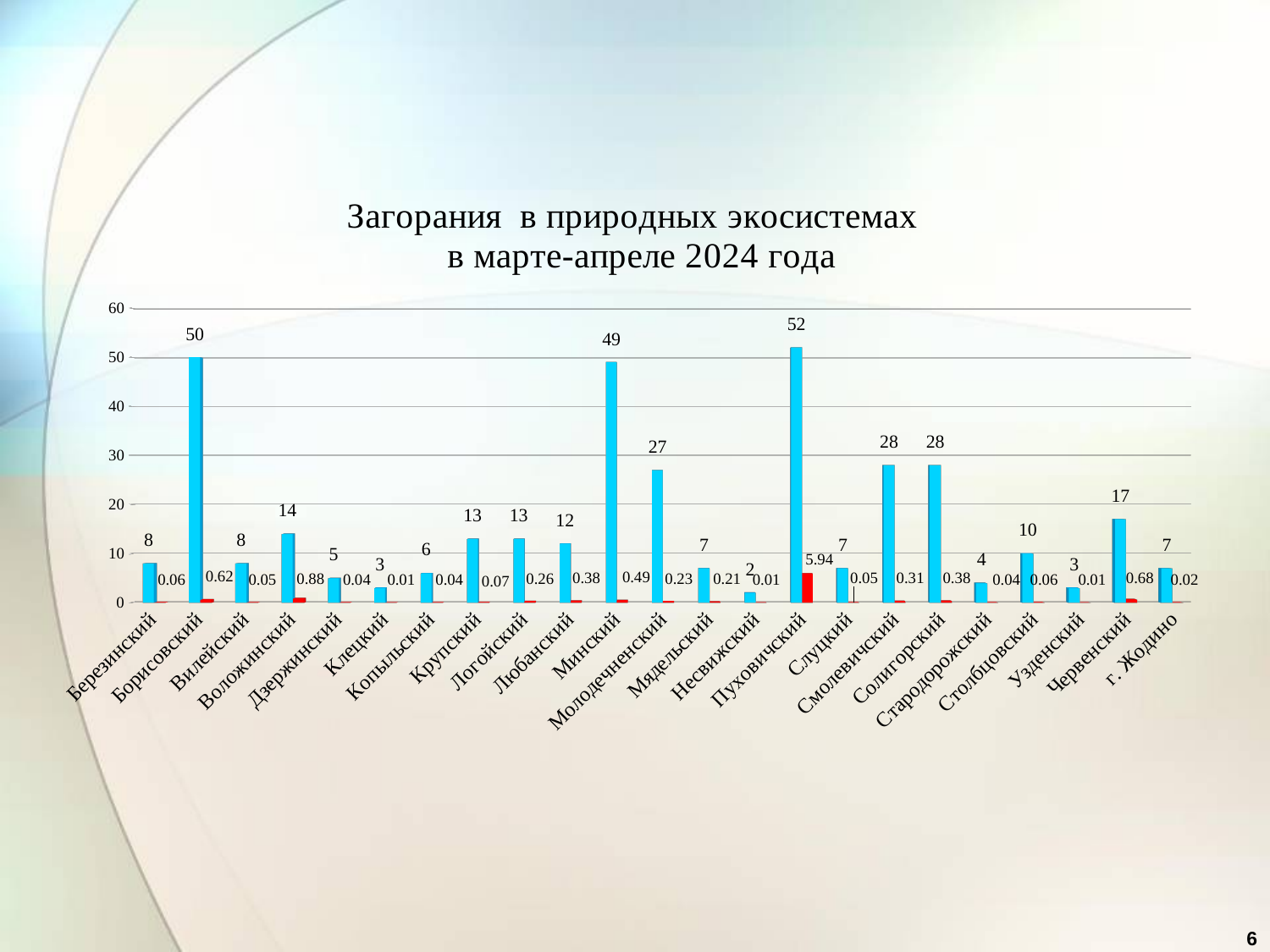
What is the value of the red bar for Пуховичский? 5.94 What is the value of the blue bar for Минский? 49 What is the value of the red bar for Воложинский? 0.88 What is the difference between the blue bar values for Борисовский and Минский? 1 Which category has the lowest blue bar? Несвижский What is the value of the blue bar for Пуховичский? 52 Is the blue bar value for Молодечненский greater or less than 30? less Which category has the highest blue bar? Пуховичский What kind of chart is shown on the slide? bar chart What is the title of the chart? Загорания в природных экосистемах в марте-апреле 2024 года Which has a larger blue bar value, Червенский or Любанский? Червенский How many categories are shown on the x axis? 23